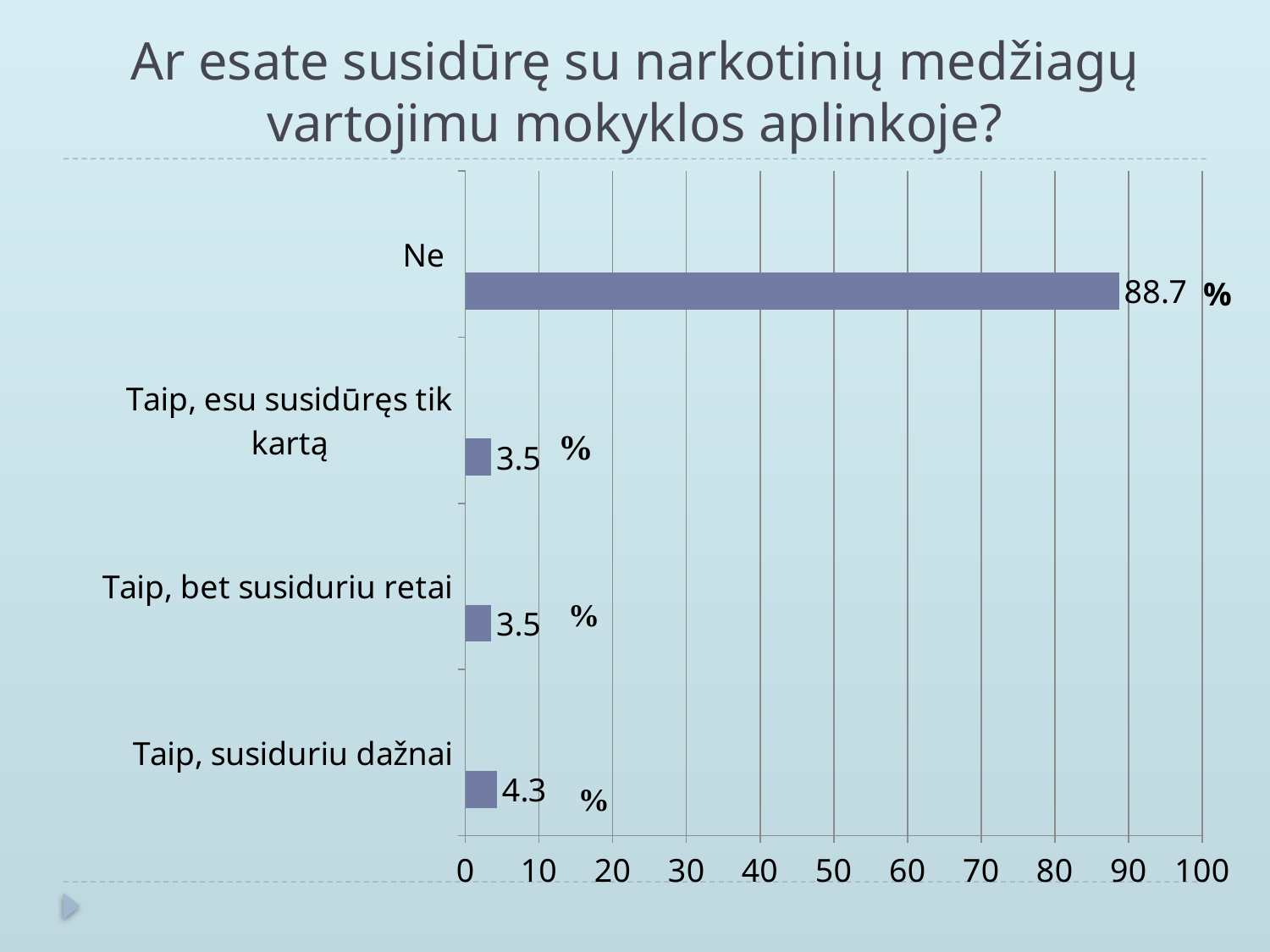
What is the title of the slide? Ar esate susidūrę su narkotinių medžiagų vartojimu mokyklos aplinkoje? Which category has the highest value? Ne How many categories are shown in the chart? 4 What is the value for "Taip, susiduriu dažnai"? 4.3 What is the value for "Taip, esu susidūręs tik kartą"? 3.5 What is the difference between the values for "Ne" and "Taip, susiduriu dažnai"? 84.4 Which is larger, the value for "Taip, susiduriu dažnai" or the value for "Taip, esu susidūręs tik kartą"? Taip, susiduriu dažnai What is the value for "Ne"? 88.7 Is the value for "Ne" greater or less than 80? greater What is the difference between the values for "Taip, susiduriu dažnai" and "Taip, bet susiduriu retai"? 0.8 What is the value for "Taip, bet susiduriu retai"? 3.5 What kind of chart is shown on the slide? bar chart